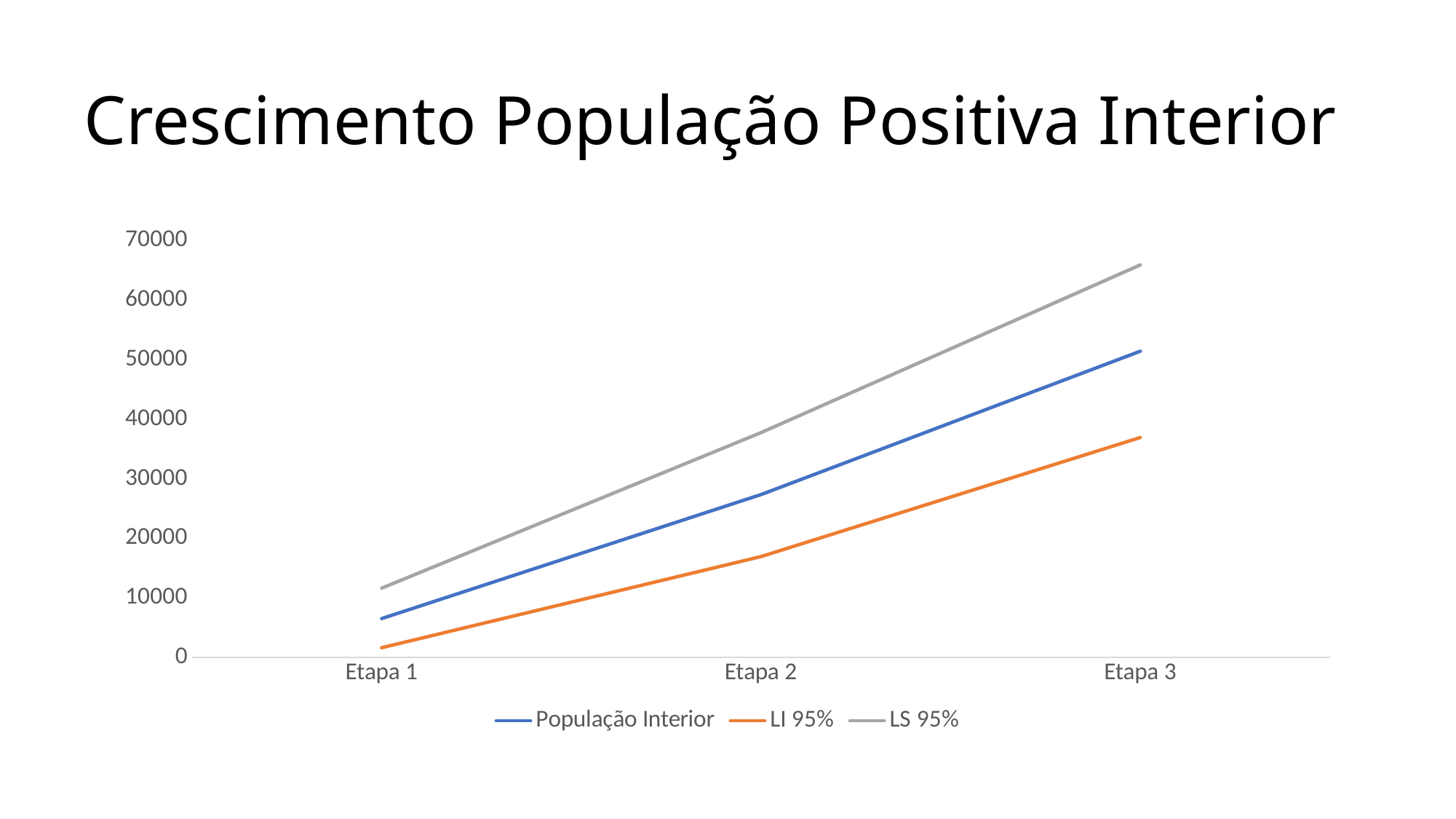
Which series is drawn in orange? LI 95% Do the values of the População Interior series rise or fall from Etapa 1 to Etapa 3? rise What is the title of the slide containing the chart? Crescimento População Positiva Interior How many categories are shown on the x axis? 3 At Etapa 2, which is larger: the value for LS 95% or the value for LI 95%? LS 95% Which series has the highest value at Etapa 3? LS 95% Is the value for LI 95% at Etapa 3 greater or less than 40000? less Which series has the lowest value at Etapa 1? LI 95% What kind of chart is shown on the slide? line chart How many series does the legend list? 3 Is the value for LS 95% at Etapa 3 greater or less than 60000? greater Is the value for População Interior at Etapa 2 greater or less than 30000? less